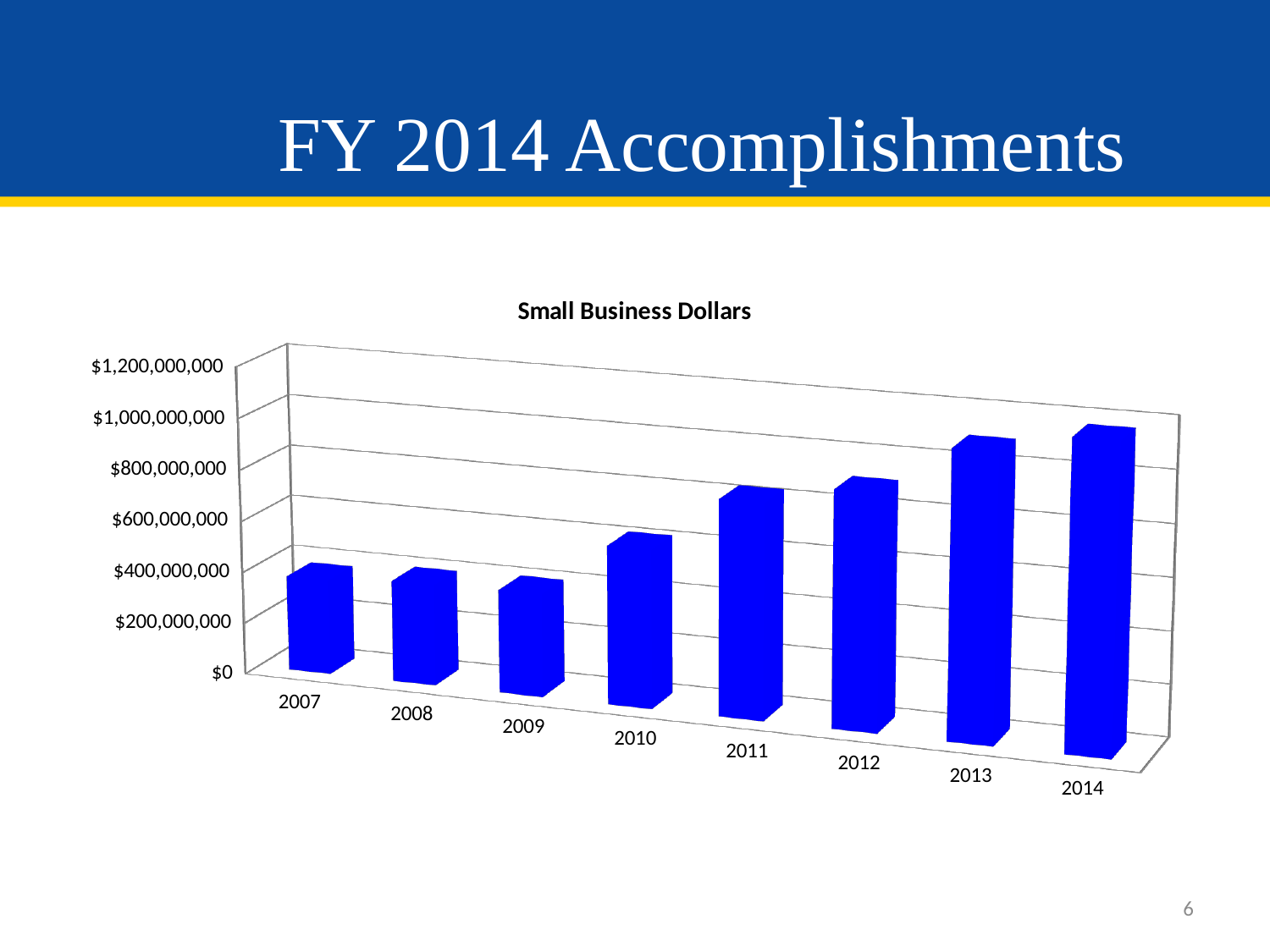
Do the Small Business Dollars values generally rise or fall from 2009 to 2014? Rise What type of chart is shown on the slide? Bar chart Which year has the larger value, 2007 or 2010? 2010 Which year has the larger value, 2011 or 2012? 2012 Is the value for 2010 greater or less than $400,000,000? greater How many years are shown on the x axis of the chart? 8 Is the value for 2009 greater or less than $600,000,000? less Is the value for 2011 greater or less than $600,000,000? greater What is the title of the chart? Small Business Dollars Which year has the highest Small Business Dollars value? 2014